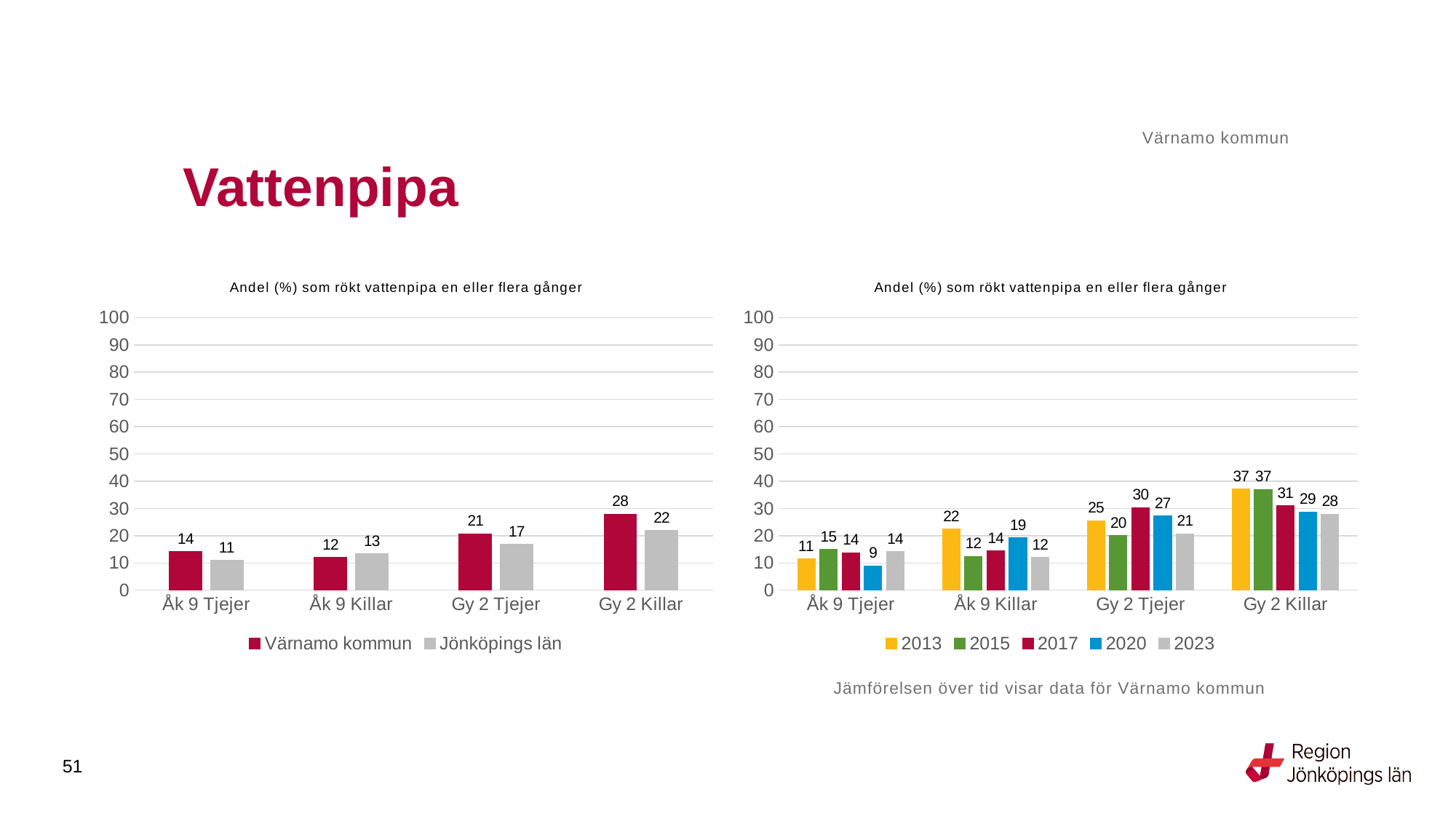
In the right chart, what is the difference between the 2013 and 2023 values for Gy 2 Killar? 9 In the left chart, what is the value for Värnamo kommun for Gy 2 Killar? 28 What kind of chart is the right chart? Bar chart In the right chart, what is the value for 2017 for Gy 2 Tjejer? 30 In the left chart, what is the value for Jönköpings län for Åk 9 Tjejer? 11 In the left chart, which is larger for Åk 9 Killar: Värnamo kommun or Jönköpings län? Jönköpings län In the left chart, what is the difference between Värnamo kommun and Jönköpings län for Gy 2 Tjejer? 4 In the right chart, which year has the lowest value for Åk 9 Killar? 2015 and 2023 In the left chart, which category has the highest value for Värnamo kommun? Gy 2 Killar In the right chart, what is the value for 2020 for Åk 9 Tjejer? 9 In the right chart, how many series does the legend list? 5 In the left chart, how many series does the legend list? 2